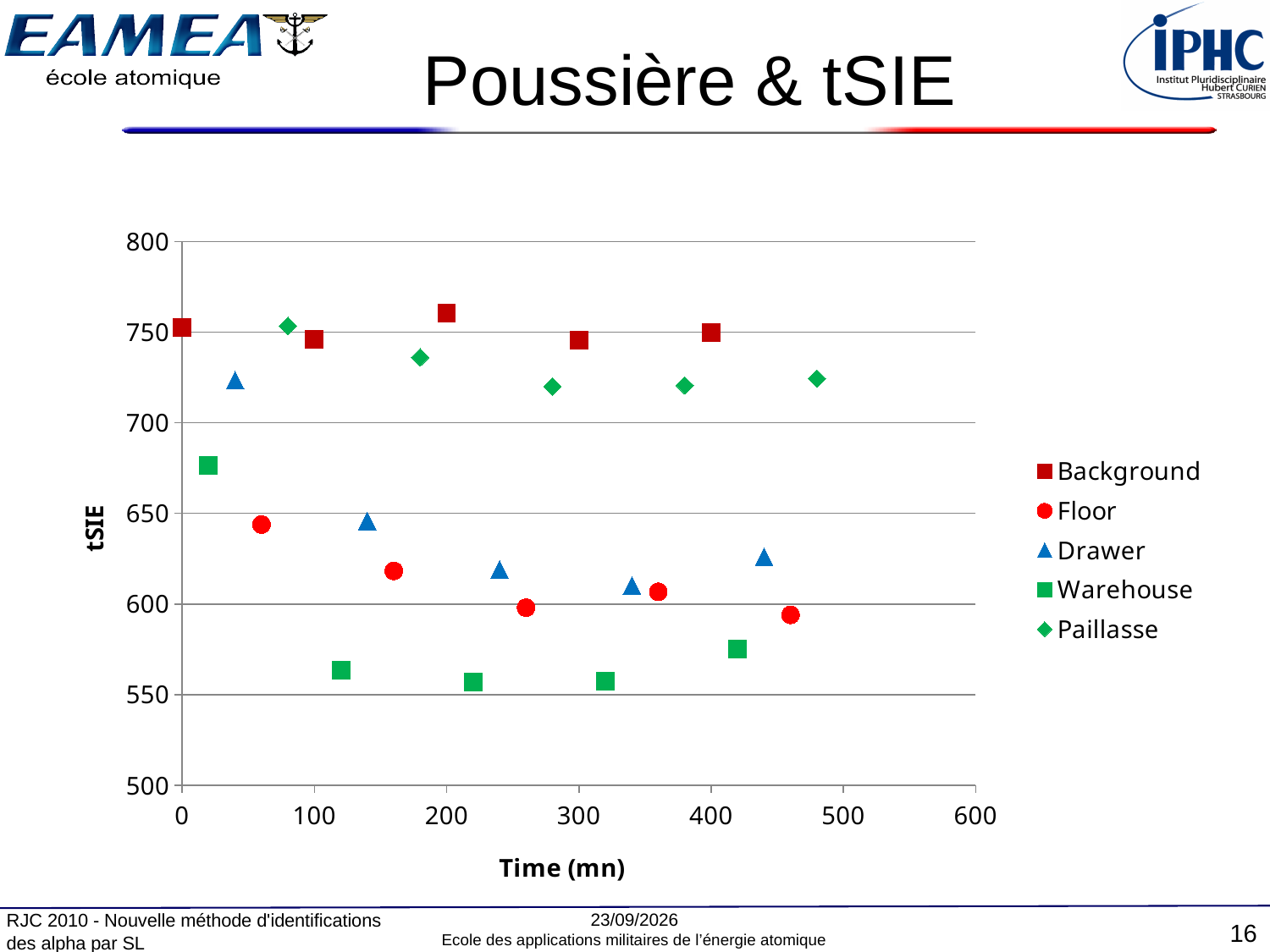
At time 400, which is higher: the Background value or the Warehouse value at time 420? Background How many series does the legend list? 5 How many data points are plotted for the Warehouse series? 5 Is the tSIE value for Warehouse at time 320 greater or less than 600? less Is the tSIE value for Background at time 200 greater or less than 750? greater What is the title of the x axis? Time (mn) How many data points are plotted for the Background series? 5 Is the tSIE value for Floor at time 160 greater or less than 600? greater What kind of chart is shown on the slide? scatter chart What is the title of the y axis? tSIE Which series has the lowest tSIE values overall? Warehouse